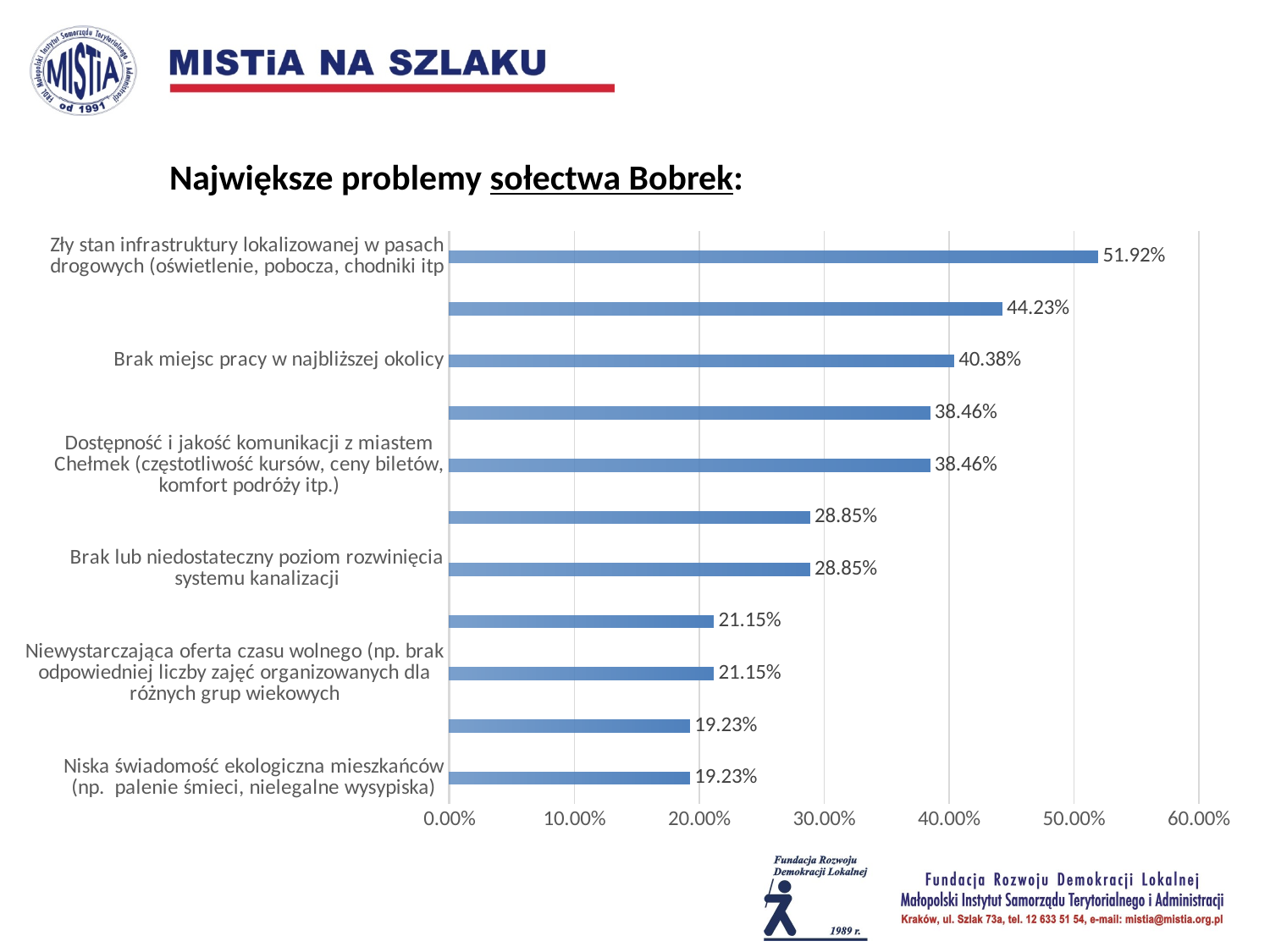
What is the value for "Niska świadomość ekologiczna mieszkańców"? 19.23% What is the value for "Brak lub niedostateczny poziom rozwinięcia systemu kanalizacji"? 28.85% Is the value for "Dostępność i jakość komunikacji z miastem Chełmek" greater or less than 40%? less What kind of chart is shown on the slide? bar chart What is the value for "Dostępność i jakość komunikacji z miastem Chełmek"? 38.46% Which is larger: the value for "Brak lub niedostateczny poziom rozwinięcia systemu kanalizacji" or for "Niewystarczająca oferta czasu wolnego"? Brak lub niedostateczny poziom rozwinięcia systemu kanalizacji How many bars are plotted on the chart? 11 What is the value for "Zły stan infrastruktury lokalizowanej w pasach drogowych"? 51.92% What is the value for "Brak miejsc pracy w najbliższej okolicy"? 40.38% Which category has the highest value? Zły stan infrastruktury lokalizowanej w pasach drogowych What is the lowest value shown on the chart? 19.23% What is the difference between the values for "Zły stan infrastruktury lokalizowanej w pasach drogowych" and "Brak miejsc pracy w najbliższej okolicy"? 11.54%